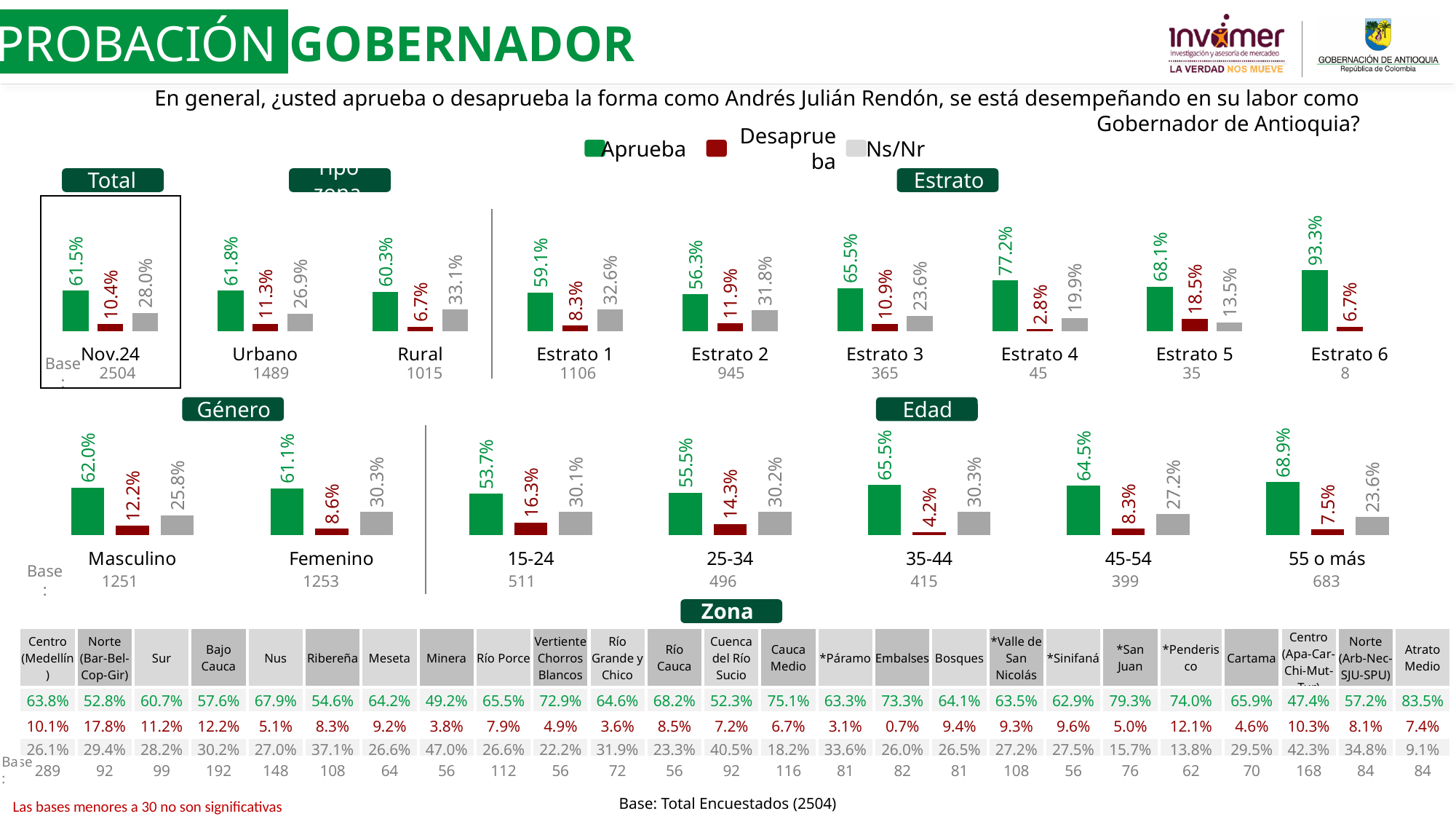
In the Estrato chart, what is the difference between the Desaprueba values for Estrato 5 and Estrato 4? 15.7 percentage points In the Total chart, what is the Aprueba value for Nov.24? 61.5% In the Estrato chart, what is the Desaprueba value for Estrato 4? 2.8% In the Edad chart, what is the Desaprueba value for 35-44? 4.2% In the Género chart, what is the difference between the Aprueba values for Masculino and Femenino? 0.9 percentage points How many estrato categories are shown in the Estrato chart? 6 In the Estrato chart, which estrato has the highest Aprueba value? Estrato 6 In the Tipo zona chart, which has the larger Desaprueba value, Urbano or Rural? Urbano How many series does the legend at the top of the slide list? 3 What kind of chart is used in the Estrato section? Bar chart In the Edad chart, what is the Ns/Nr value for 55 o más? 23.6% In the Edad chart, which age group has the lowest Aprueba value? 15-24